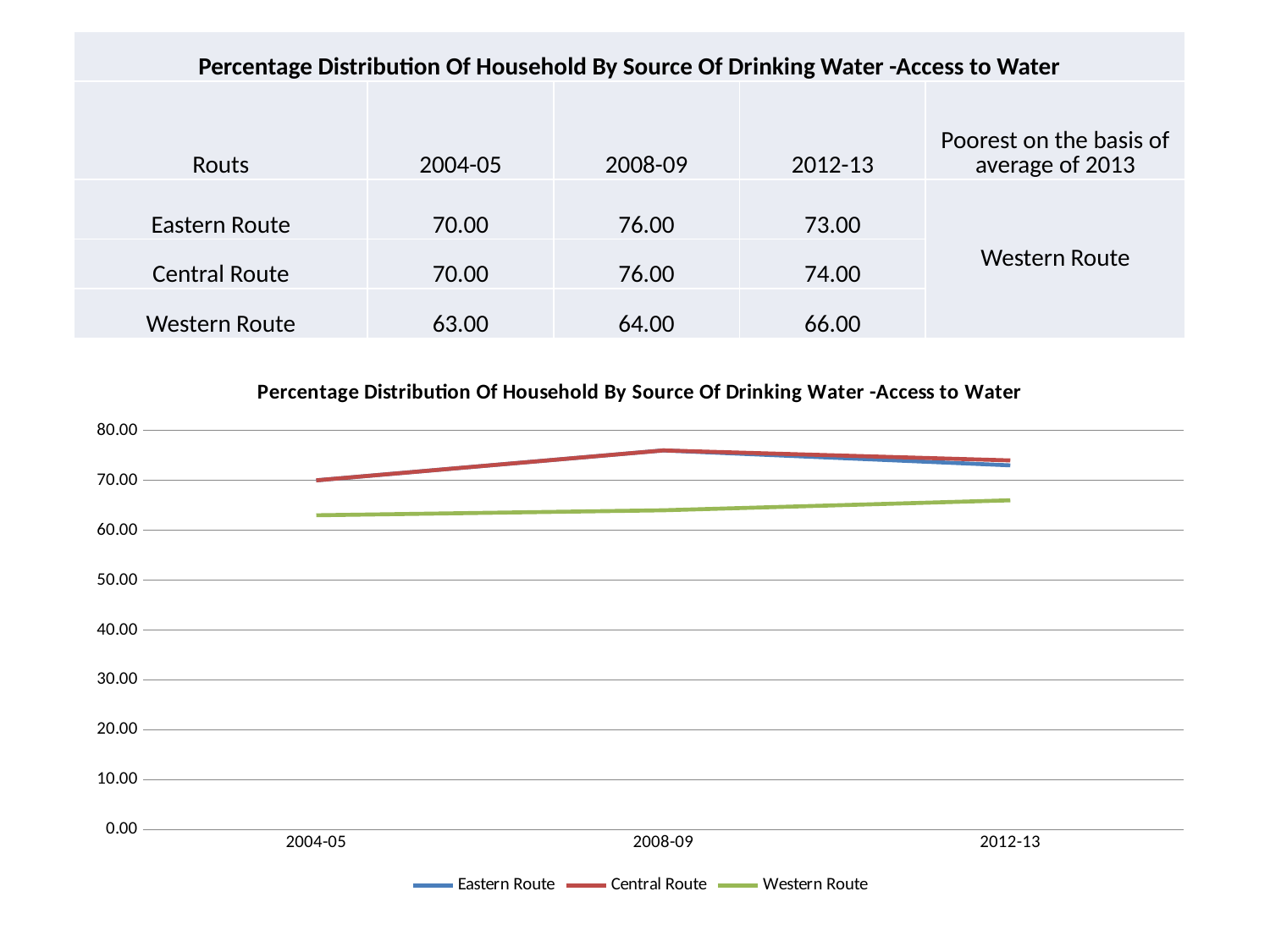
What is the value for Central Route in 2012-13? 74.00 What is the value for Eastern Route in 2008-09? 76.00 Which route has the lowest value in 2012-13? Western Route Does the Western Route line rise or fall from 2004-05 to 2012-13? rise What is the value for Western Route in 2004-05? 63.00 Is the value for Western Route in 2012-13 greater or less than 70.00? less How many periods are shown on the x axis of the chart? 3 What is the difference between the Eastern Route and Western Route values in 2008-09? 12.00 What kind of chart is shown on the slide? line chart How many series does the chart legend list? 3 Which route has the highest value in 2012-13? Central Route What colour is the Western Route line in the chart? green